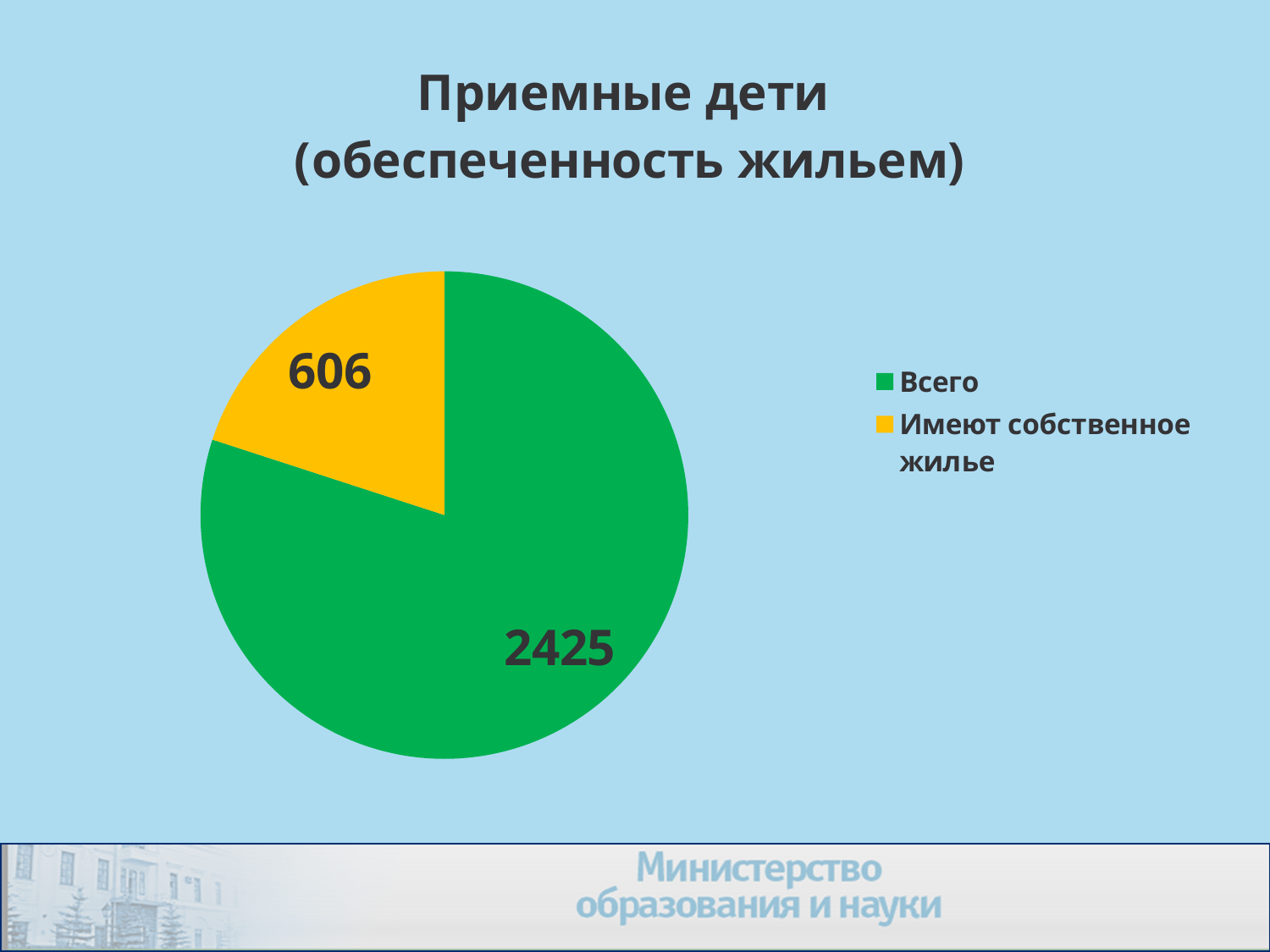
What is the difference between the value for Всего and the value for Имеют собственное жилье? 1819 Which slice of the pie is the smallest? Имеют собственное жилье What type of chart is shown on the slide? pie chart What is the title of the chart? Приемные дети (обеспеченность жильем) What is the value for Имеют собственное жилье? 606 How many entries does the legend list? 2 Which slice of the pie is the largest? Всего What is the value for Всего? 2425 How many slices does the pie chart have? 2 What colour is the slice for Имеют собственное жилье? yellow Which is larger, the value for Всего or the value for Имеют собственное жилье? Всего